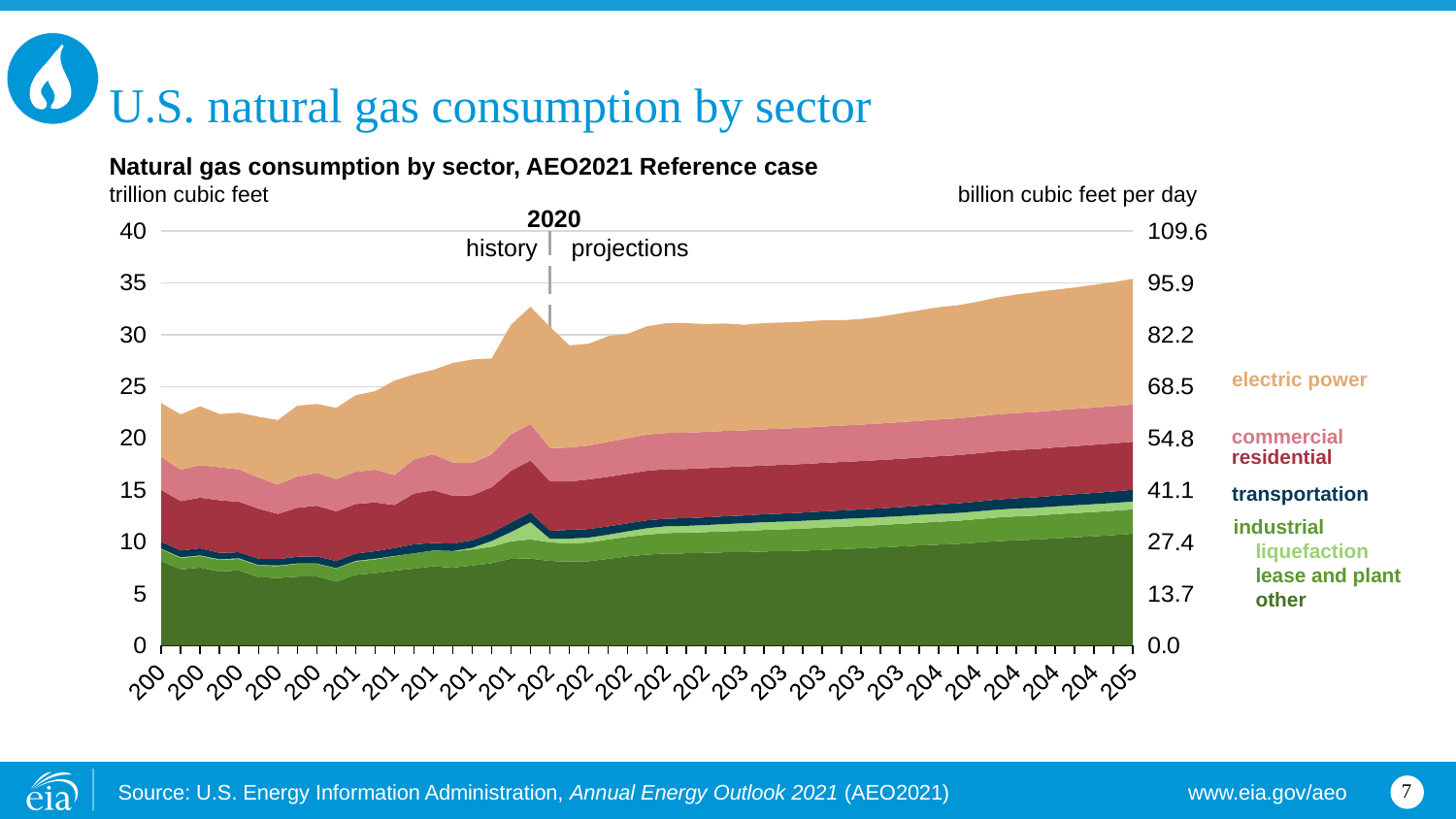
What kind of chart is shown on the slide? stacked area chart Is the total natural gas consumption at the start of the series greater or less than 25 trillion cubic feet? less Does total natural gas consumption rise or fall over the projection period after 2020? rise What is the title of the chart? Natural gas consumption by sector, AEO2021 Reference case Which is larger at the end of the projection period, the industrial layer or the commercial layer? industrial Which sector forms the top layer of the stacked area chart? electric power Is the total natural gas consumption at the end of the projection period greater or less than 30 trillion cubic feet? greater Is the total natural gas consumption at the 2020 peak greater or less than 30 trillion cubic feet? greater Which is larger at the end of the projection period, the electric power layer or the transportation layer? electric power Which year separates history from projections in the chart? 2020